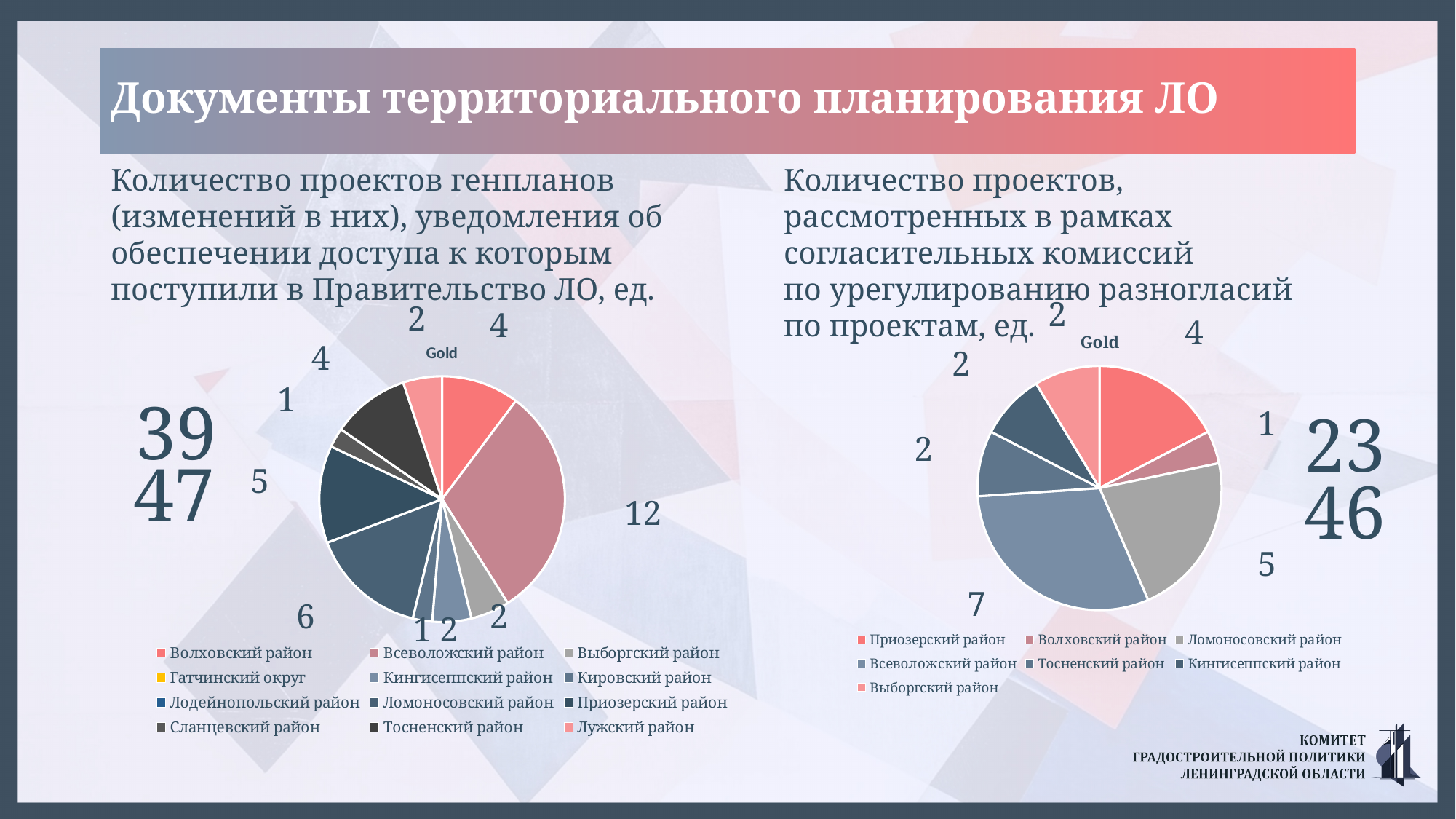
How many entries does the legend of the left pie chart list? 12 How many entries does the legend of the right pie chart list? 7 In the right pie chart, what is the difference between the values for Всеволожский район and Ломоносовский район? 2 In the left pie chart, what is the value for Всеволожский район? 12 In the right pie chart, which district has the smallest value? Волховский район In the right pie chart, which district has the largest value? Всеволожский район In the right pie chart, what is the value for Приозерский район? 4 What type of chart is used on the left side of the slide? Pie chart In the right pie chart, what is the value for Ломоносовский район? 5 In the left pie chart, what is the value for Волховский район? 4 In the right pie chart, what is the value for Всеволожский район? 7 In the left pie chart, which district has the largest slice? Всеволожский район